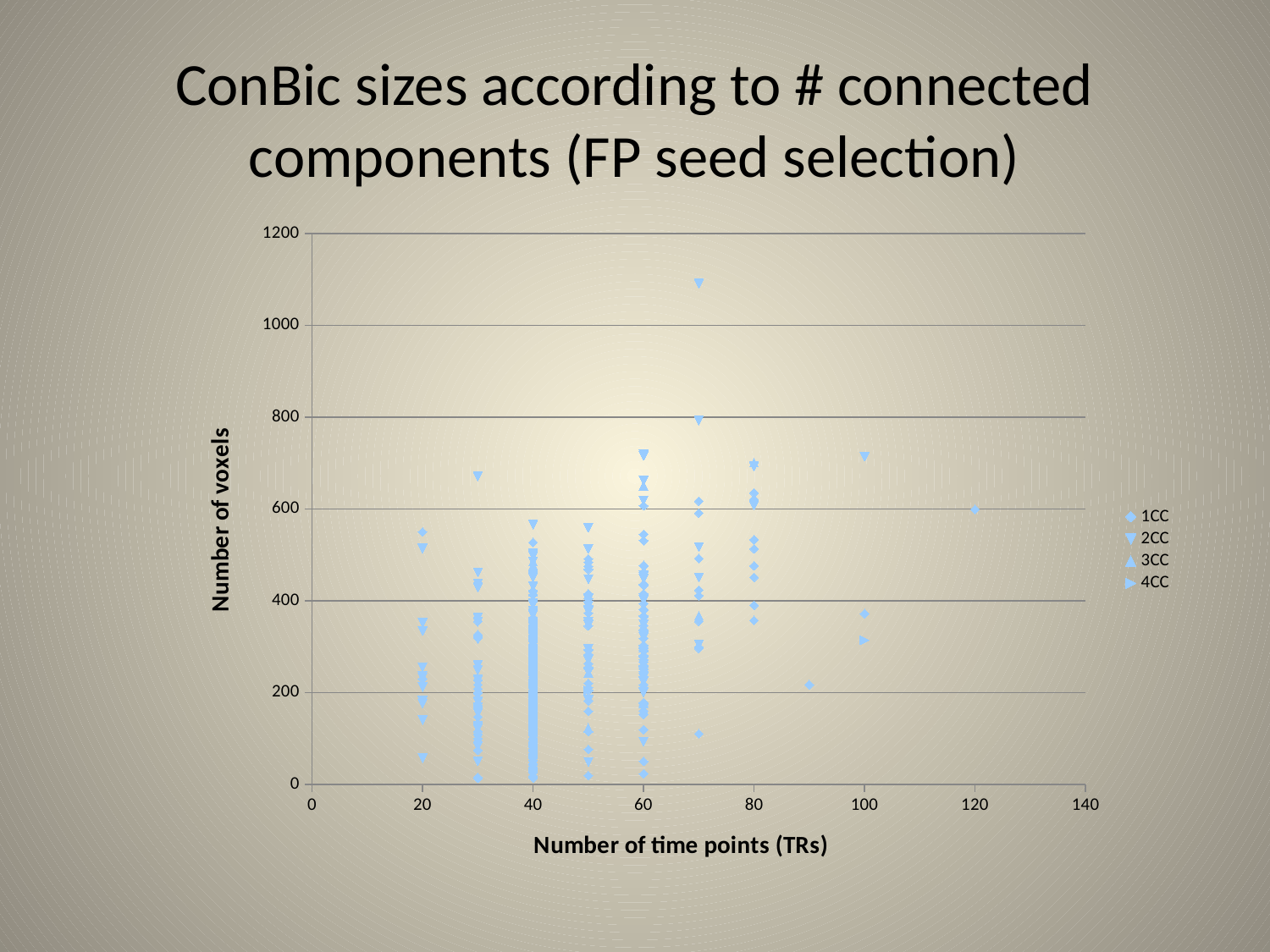
Is the highest point at 20 time points greater or less than 600? less Is the value for the single point at 120 time points greater or less than 400? greater What is the maximum value shown on the vertical axis? 1200 What kind of chart is shown on the slide? scatter chart What are the series names listed in the legend? 1CC, 2CC, 3CC, 4CC Is the value for the 4CC point at 100 time points greater or less than 400? less At which number of time points does the highest point on the chart appear? 70 What is the title of the vertical axis? Number of voxels How many series does the legend list? 4